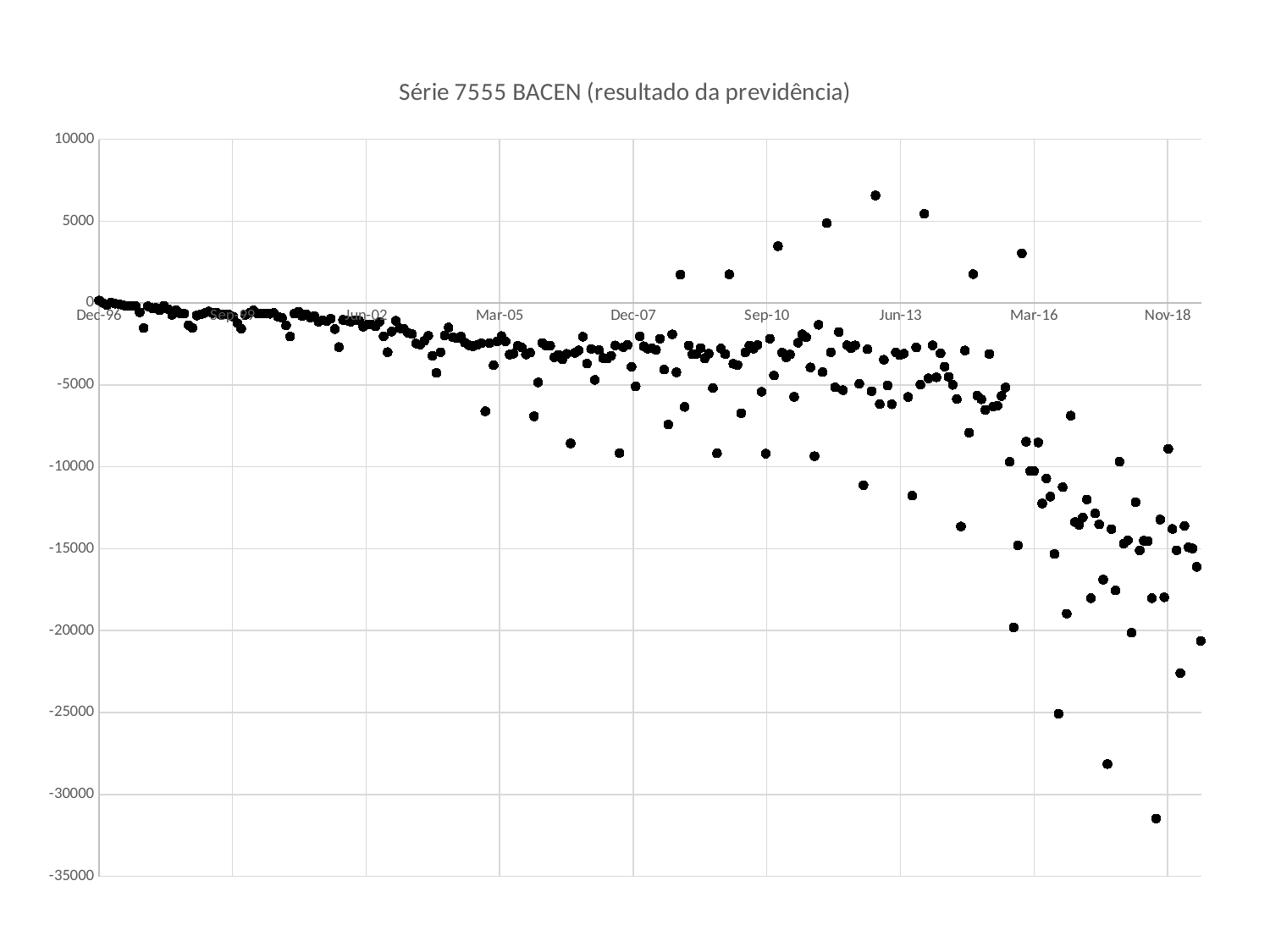
What is the title of the chart? Série 7555 BACEN (resultado da previdência) Is the lowest plotted value greater or less than -35000? greater Is the highest plotted value greater or less than 5000? greater Are the values plotted near Dec-96 greater or less than -5000? greater Do the plotted values generally rise or fall from Dec-96 to Nov-18? fall What kind of chart is shown on the slide? scatter chart What is the last date label shown on the x axis? Nov-18